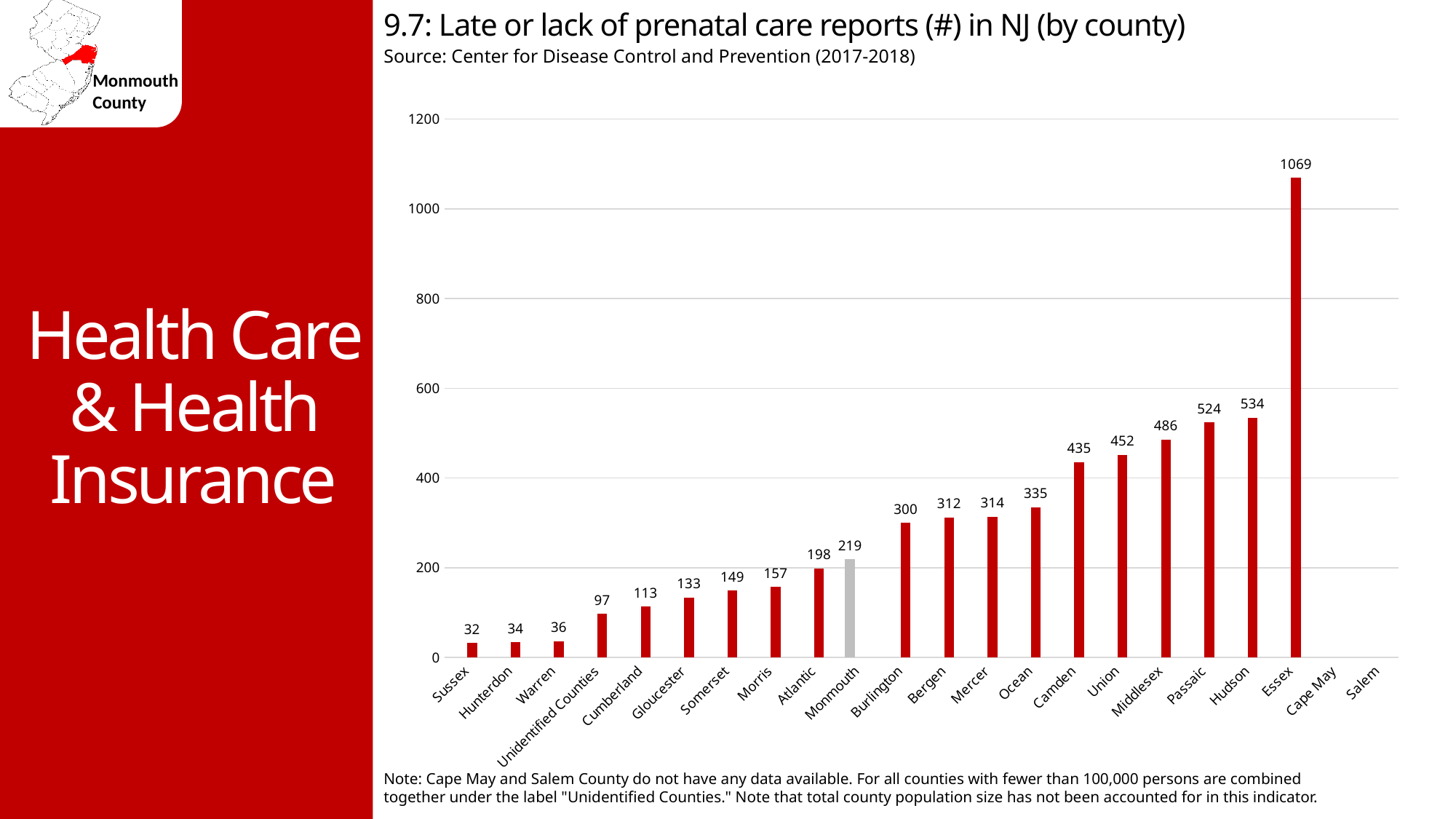
Which county has the highest number of late or lack of prenatal care reports? Essex What is the value shown for Essex County? 1069 Which bar is coloured grey instead of red? Monmouth Which has a larger value, Camden or Burlington? Camden What is the difference between the values for Essex and Hudson? 535 What is the difference between the values for Hudson and Passaic? 10 What is the value shown for Unidentified Counties? 97 Is the value for Middlesex greater or less than 400? greater What is the number of late or lack of prenatal care reports for Monmouth County? 219 Which county with a plotted value has the lowest number of reports? Sussex What kind of chart is shown on the slide? Bar chart How many counties are listed on the x axis, including Unidentified Counties? 22